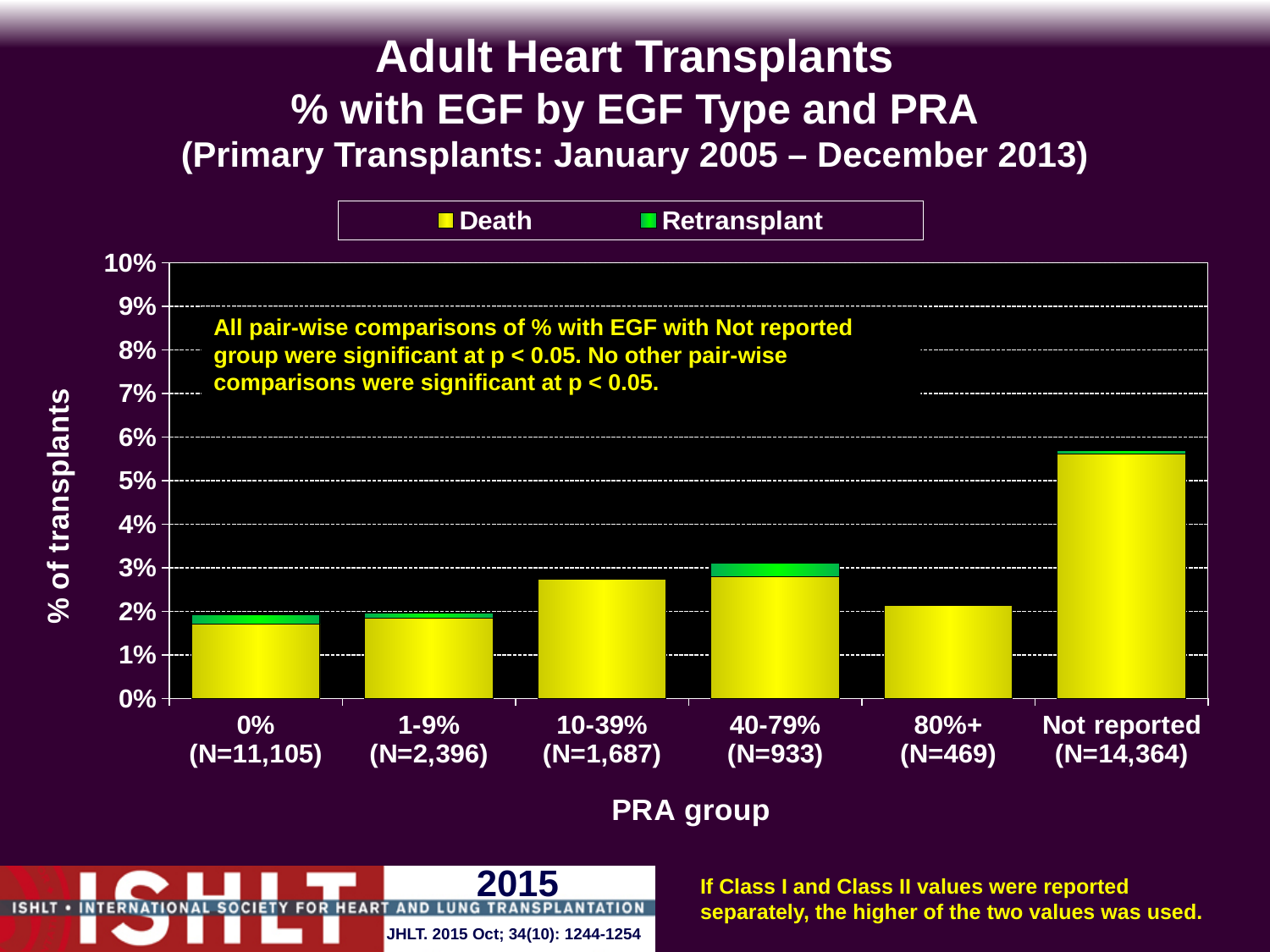
What is the title of the x axis? PRA group Is the total value for the 10-39% PRA group greater or less than 3%? less What is the N shown for the Not reported PRA group? N=14,364 Which PRA group has the highest total % with EGF? Not reported What kind of chart is shown on the slide? Stacked bar chart How many PRA group categories are shown on the x axis? 6 How many series does the legend list? 2 Which has a larger total % with EGF: the Not reported group or the 0% PRA group? Not reported Is the total value for the Not reported group greater or less than 5%? greater Which has a larger total % with EGF: the 10-39% PRA group or the 1-9% PRA group? 10-39% Is the total value for the 40-79% PRA group greater or less than 2%? greater